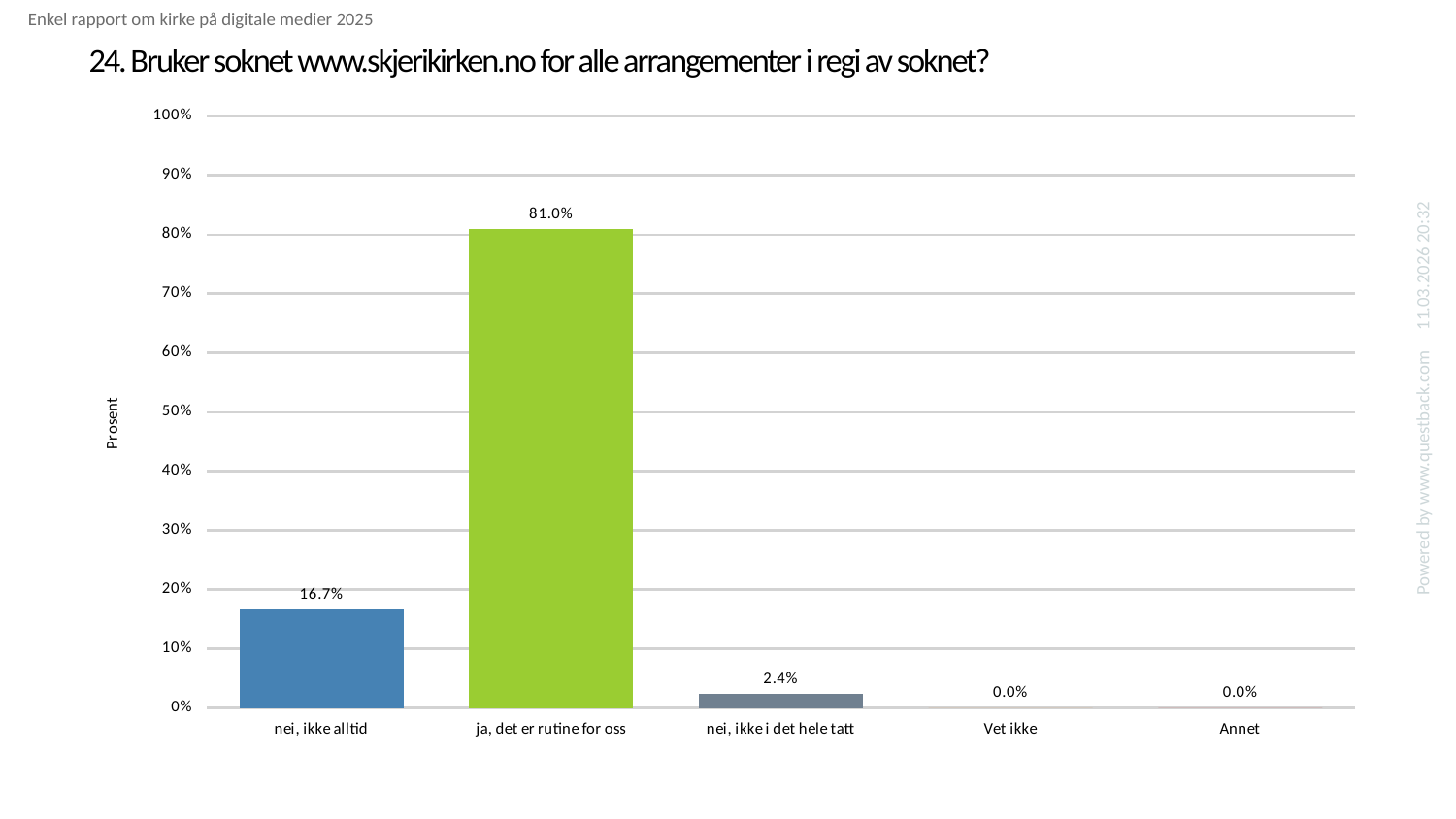
What is the value for "Vet ikke"? 0.0% How many categories are shown on the x axis? 5 What is the value for "ja, det er rutine for oss"? 81.0% What is the difference between the values for "ja, det er rutine for oss" and "nei, ikke alltid"? 64.3% Which category has the highest value? ja, det er rutine for oss What kind of chart is shown on the slide? bar chart Is the value for "ja, det er rutine for oss" greater or less than 70%? greater What is the title of the chart? 24. Bruker soknet www.skjerikirken.no for alle arrangementer i regi av soknet? What is the value for "nei, ikke i det hele tatt"? 2.4% What is the value for "nei, ikke alltid"? 16.7% Which is larger, the value for "nei, ikke alltid" or the value for "nei, ikke i det hele tatt"? nei, ikke alltid What is the label of the y axis? Prosent